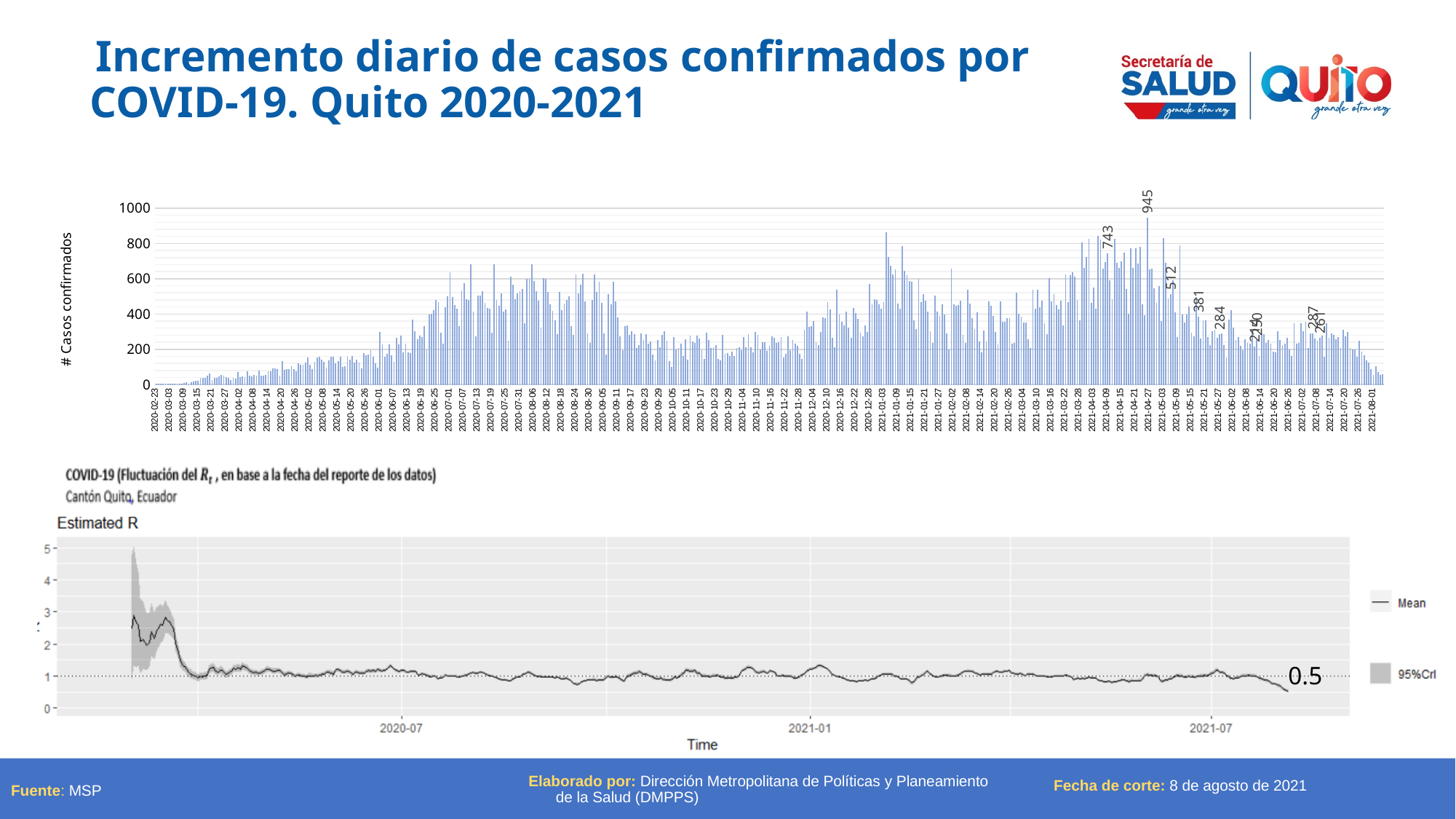
What kind of chart is the bottom chart titled 'COVID-19 (Fluctuación del Rt...)'? line chart In the top chart, what is the difference between the labelled values 381 and 284? 97 What is the y-axis label of the top chart? # Casos confirmados In the bottom chart, what is the labelled value of the estimated R at the end of the series? 0.5 How many entries does the legend of the bottom chart list? 2 In the top chart, what is the highest labelled daily value of confirmed cases? 945 What is the x-axis label of the bottom chart? Time In the bottom chart, does the estimated R rise or fall from the start of the series to its end? fall In the top chart, what is the difference between the labelled values 945 and 743? 202 What kind of chart is the top chart showing daily confirmed cases? bar chart In the bottom chart, is the estimated R at 2021-01 greater or less than 2? less In the top chart, which labelled value is larger, 512 or 381? 512